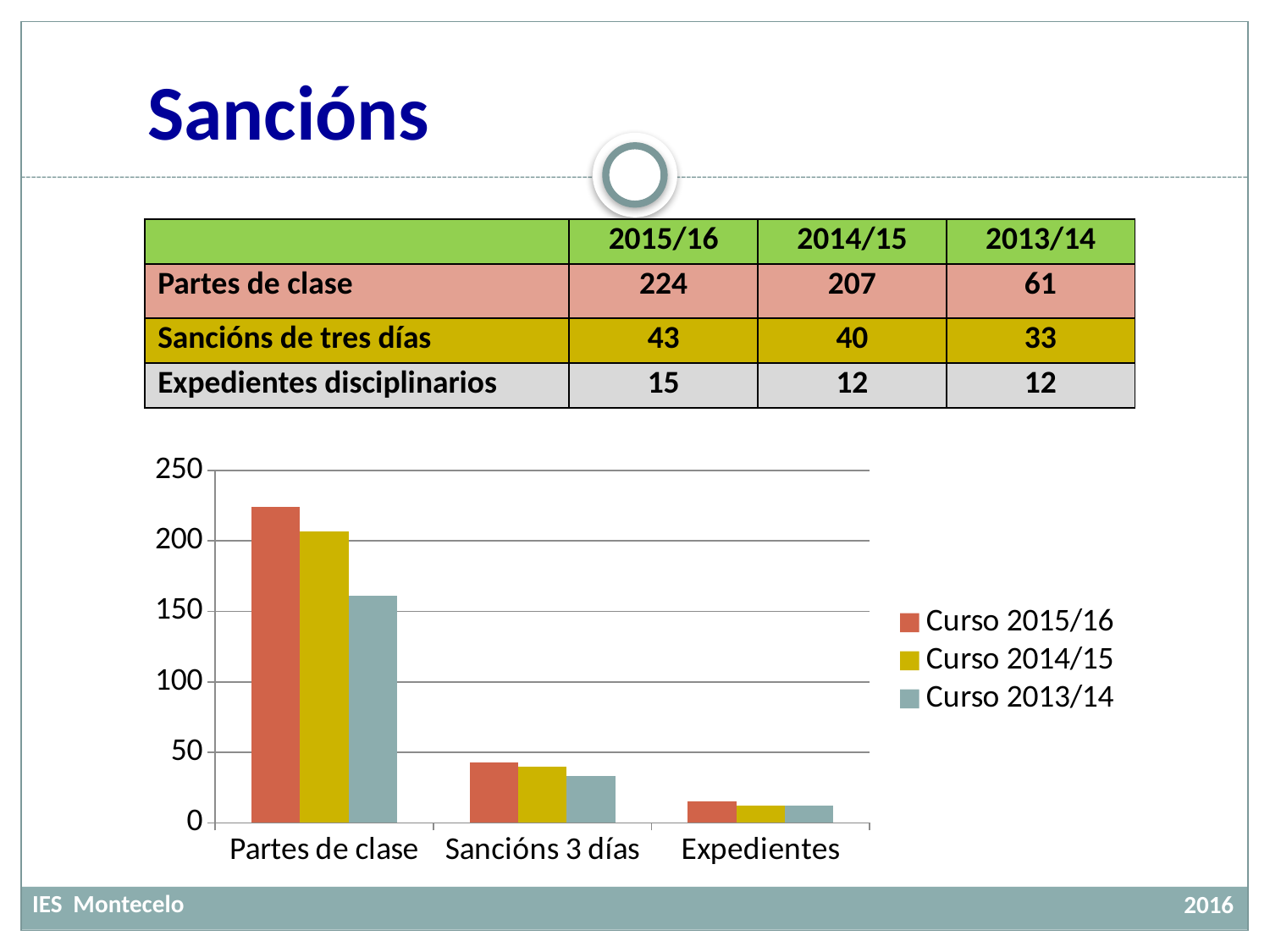
What kind of chart is shown on the slide? bar chart Is the value for Partes de clase in Curso 2015/16 greater or less than 200? greater Is the value for Expedientes in Curso 2013/14 greater or less than 50? less What is the value for Partes de clase in 2015/16 according to the table? 224 Which category has the highest bars in the chart? Partes de clase What is the difference between Partes de clase in 2015/16 and 2014/15 according to the table? 17 Do the values in the chart rise or fall from left to right across the categories? fall How many categories are shown on the x axis of the chart? 3 Which category has the lowest bars in the chart? Expedientes Is the value for Sancións 3 días in Curso 2015/16 greater or less than 50? less How many series does the chart's legend list? 3 Which is larger for Partes de clase: Curso 2015/16 or Curso 2014/15? Curso 2015/16